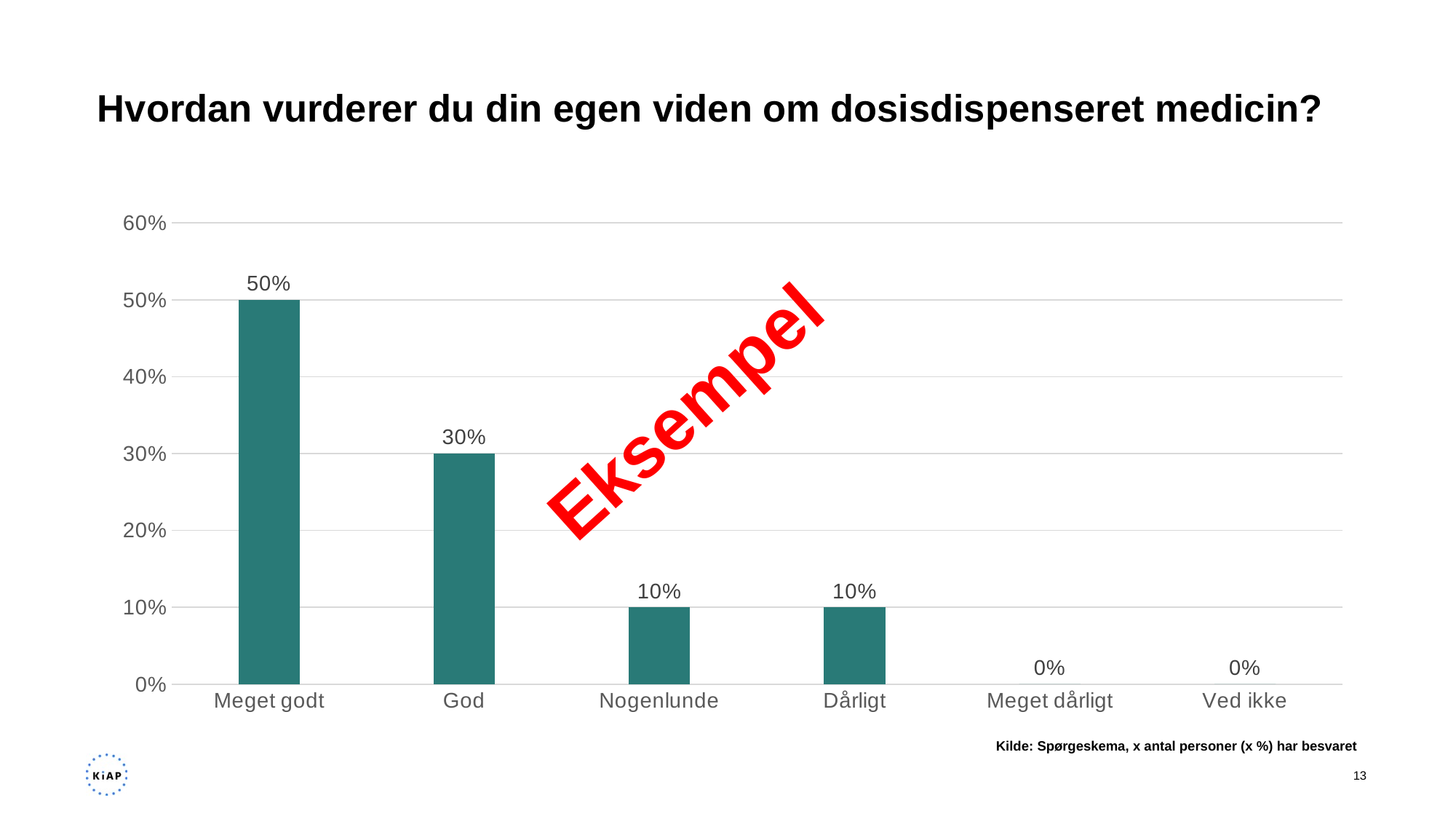
Is the value for Meget godt greater or less than 40%? greater What is the title of the chart? Hvordan vurderer du din egen viden om dosisdispenseret medicin? What kind of chart is shown on the slide? bar chart Which is larger, the value for God or the value for Dårligt? God How many categories are shown on the x axis? 6 What is the value for Ved ikke? 0% What is the value for God? 30% Which category has the highest value? Meget godt What is the difference between the values for Meget godt and God? 20% Do the values generally rise or fall from left to right along the x axis? fall What is the value for Meget godt? 50% What is the value for Nogenlunde? 10%